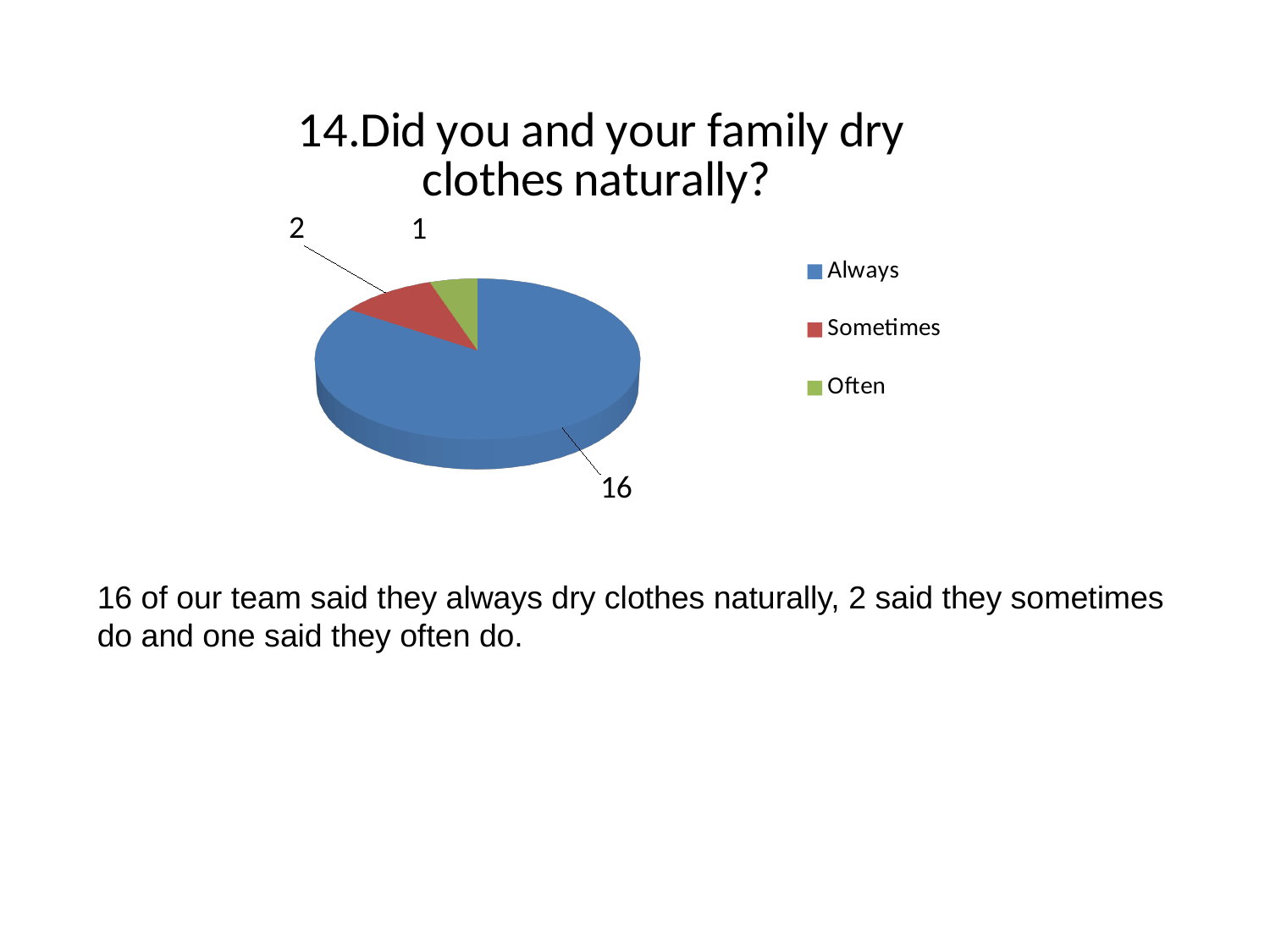
What is the difference between the values for Always and Sometimes? 14 Which category has the smallest slice? Often What is the value for Often? 1 How many categories does the pie chart have? 3 What kind of chart is shown on the slide? pie chart Which category has the largest slice? Always Which is larger, the value for Sometimes or the value for Often? Sometimes What is the title of the chart? 14.Did you and your family dry clothes naturally? What is the total of all the slices in the pie chart? 19 What is the value for Sometimes? 2 What is the value for Always? 16 What colour is the Sometimes slice? red